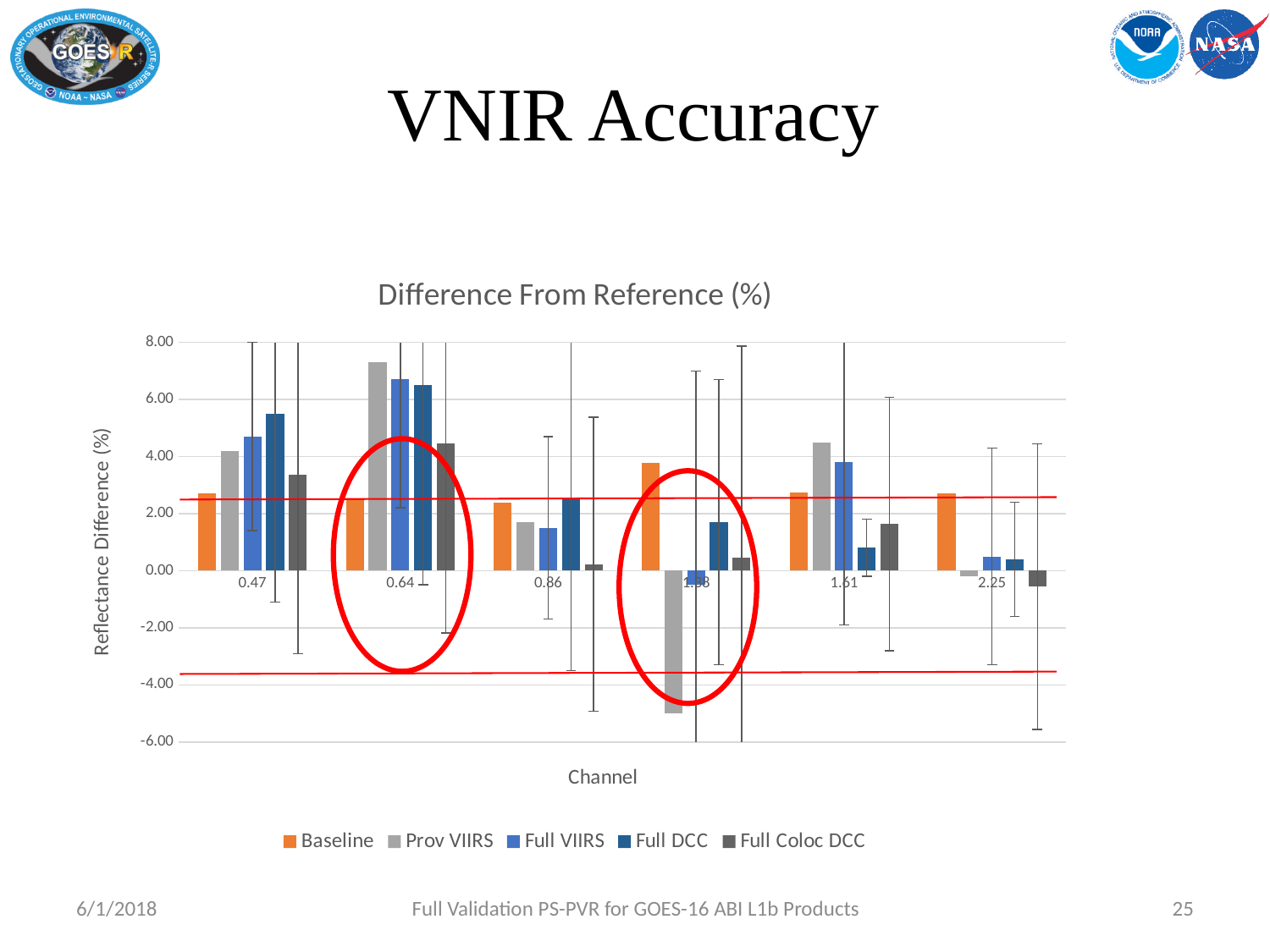
Is the Prov VIIRS value for channel 1.38 greater or less than -4.00? less Which channel contains the lowest bar in the chart? 1.38 Is the Baseline value for channel 1.38 greater or less than 2.00? greater Which series has the highest value for channel 0.64? Prov VIIRS For channel 0.47, which is larger: the Baseline value or the Full DCC value? Full DCC What type of chart is shown on the slide? bar chart What is the title of the chart? Difference From Reference (%) Is the Prov VIIRS value for channel 0.64 greater or less than 6.00? greater What is the label of the y axis? Reflectance Difference (%) How many series does the legend list? 5 How many channel categories are plotted along the x axis? 6